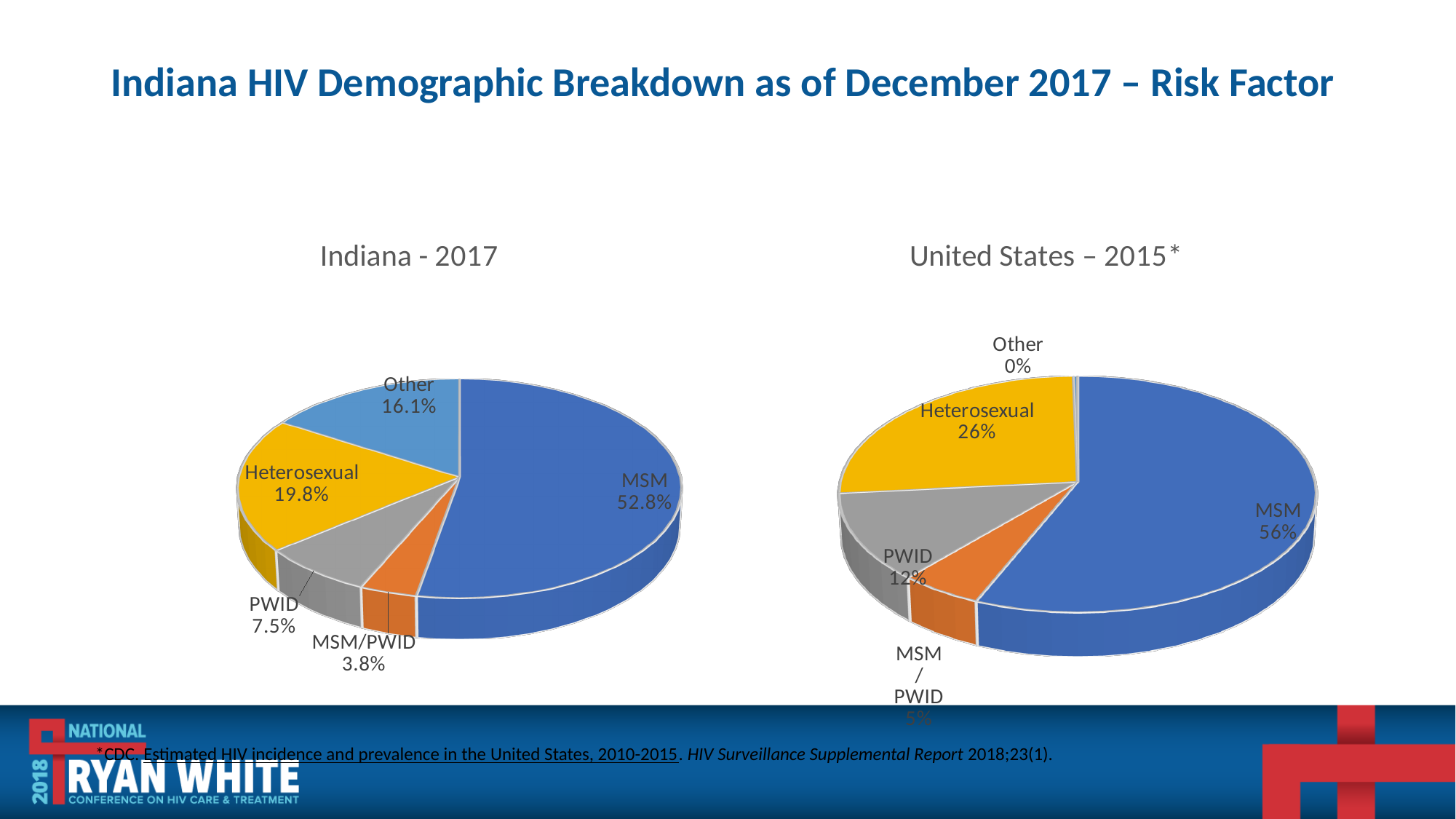
In the United States – 2015 pie chart, what share is labelled for PWID? 12% In the Indiana - 2017 pie chart, which is larger, the Other slice or the PWID slice? Other In the Indiana - 2017 pie chart, what share is labelled for MSM? 52.8% In the Indiana - 2017 pie chart, what is the difference between the Heterosexual share and the Other share? 3.7% In the Indiana - 2017 pie chart, which category has the largest slice? MSM In the United States – 2015 pie chart, which category has the smallest slice? Other In the United States – 2015 pie chart, what is the difference between the MSM share and the Heterosexual share? 30% In the Indiana - 2017 pie chart, which category has the smallest slice? MSM/PWID In the United States – 2015 pie chart, what share is labelled for Heterosexual? 26% What type of chart is used on this slide? Pie chart In the Indiana - 2017 pie chart, what share is labelled for PWID? 7.5% In the Indiana - 2017 pie chart, what share is labelled for Heterosexual? 19.8%